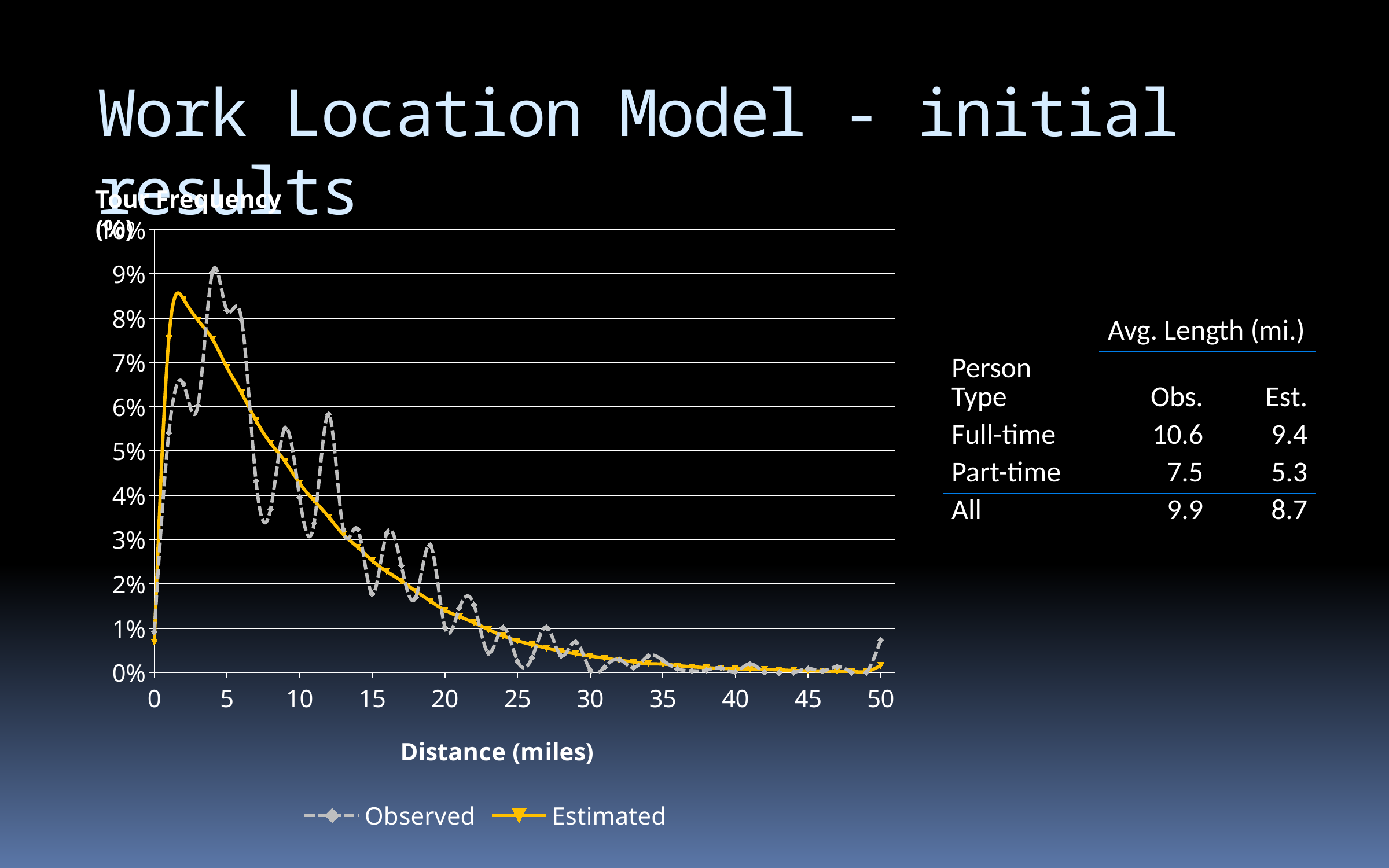
Is the peak value of the Estimated series greater or less than 9%? less What kind of chart is shown on the slide? line chart After the peak near 2 to 4 miles, do the values generally rise or fall as distance increases? fall What is the title of the chart's x axis? Distance (miles) At a distance of 8 miles, which series has the higher value, Observed or Estimated? Estimated Is the Estimated value at 30 miles greater or less than 1%? less Is the peak value of the Estimated series greater or less than 8%? greater Which series reaches the higher peak value, Observed or Estimated? Observed What are the two series named in the chart's legend? Observed and Estimated How many series does the chart's legend list? 2 At a distance of 5 miles, which series has the higher value, Observed or Estimated? Observed